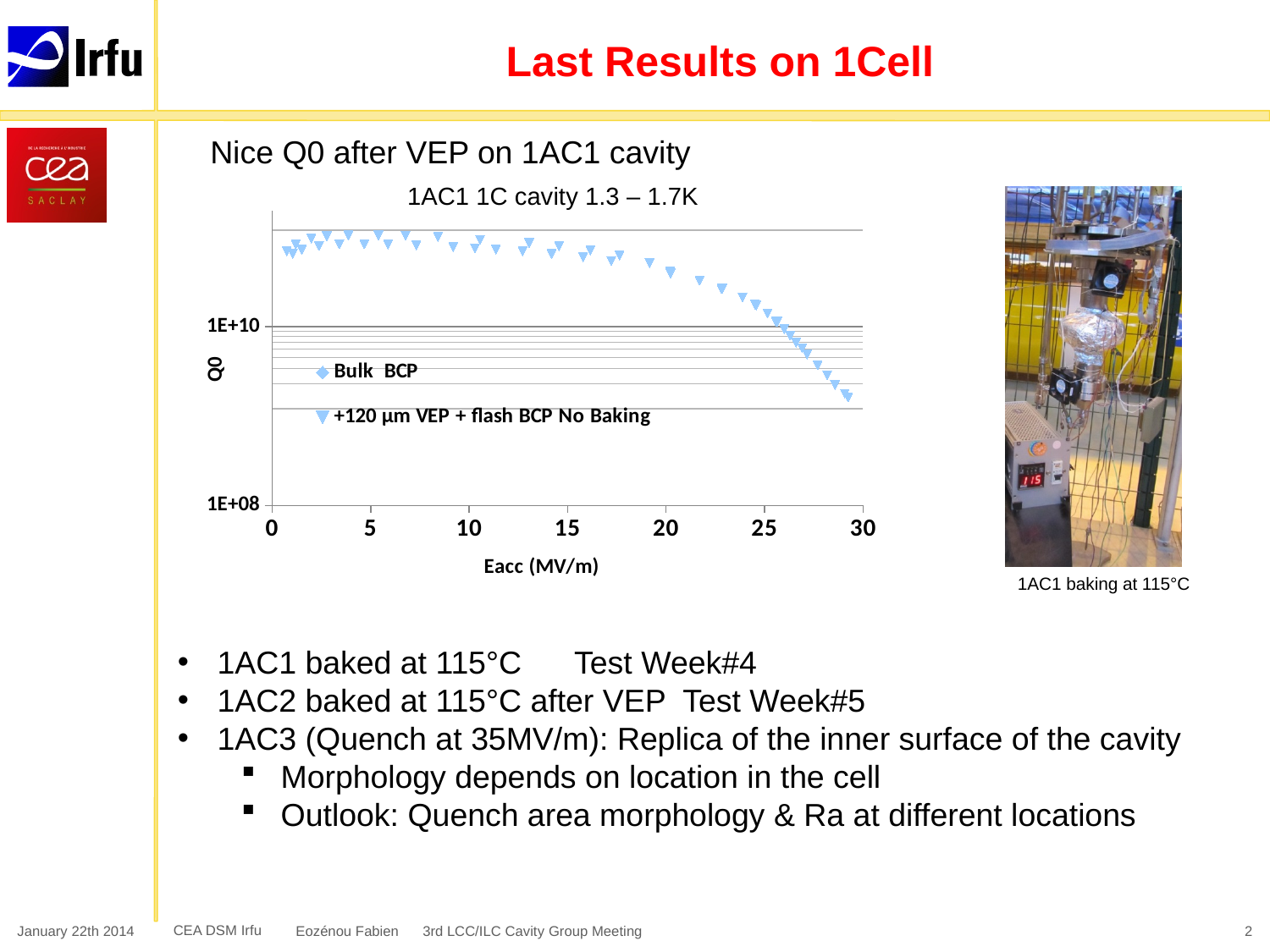
What is the label of the x axis of the chart? Eacc (MV/m) What is the title of the chart? 1AC1 1C cavity 1.3 – 1.7K Which is larger for the '+120 µm VEP + flash BCP No Baking' series: the Q0 value at Eacc = 5 MV/m or at Eacc = 28 MV/m? Eacc = 5 MV/m What is the highest Eacc tick value shown on the x axis of the chart? 30 Is the Q0 value for the '+120 µm VEP + flash BCP No Baking' series at Eacc = 29 MV/m greater or less than 1E+10? less How many series does the chart legend list? 2 Is the Q0 value for the '+120 µm VEP + flash BCP No Baking' series at Eacc = 10 MV/m greater or less than 1E+10? greater What kind of chart is shown on the slide? scatter chart Does Q0 for the '+120 µm VEP + flash BCP No Baking' series rise or fall as Eacc increases from 20 to 30 MV/m? fall Is the Q0 value for the '+120 µm VEP + flash BCP No Baking' series at Eacc = 5 MV/m greater or less than 1E+08? greater